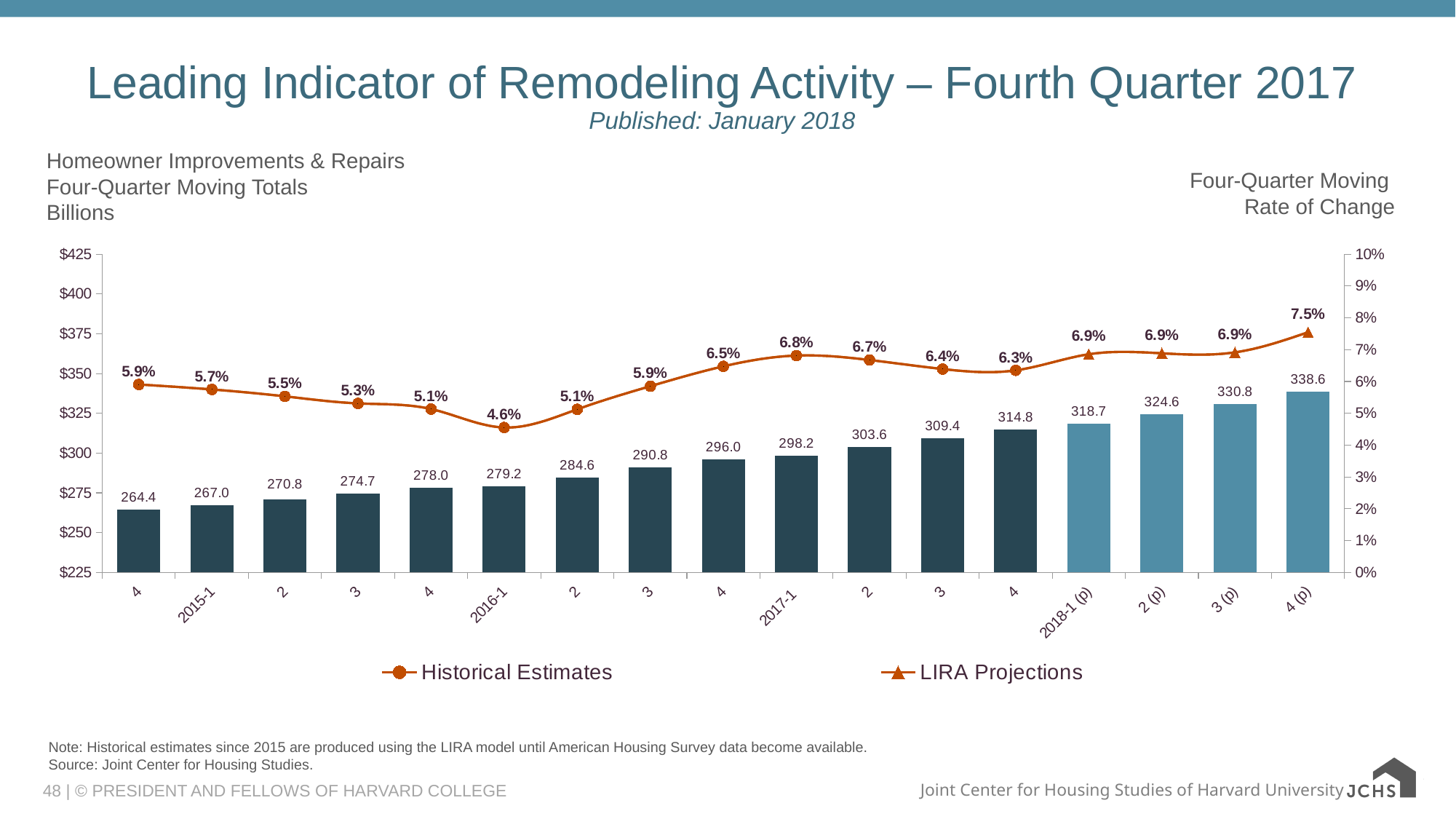
How many periods (bars) are shown on the x axis? 17 What is the projected four-quarter moving total for 4 (p) of 2018? 338.6 What is the difference between the four-quarter moving totals for 2018-1 (p) and 2017-1? 20.5 What is the four-quarter moving total (in billions) for 2017-1? 298.2 Which is larger, the rate of change for 2017-1 or for 2017-4? 2017-1 Which period has the lowest four-quarter moving rate of change? 2016-1 Is the four-quarter moving total for 2016-2 greater or less than $300? less Which period has the highest four-quarter moving rate of change? 4 (p) Do the four-quarter moving totals rise or fall from left to right along the x axis? rise What are the two series named in the legend? Historical Estimates and LIRA Projections How many series does the legend list? 2 What is the four-quarter moving rate of change for 2016-1? 4.6%